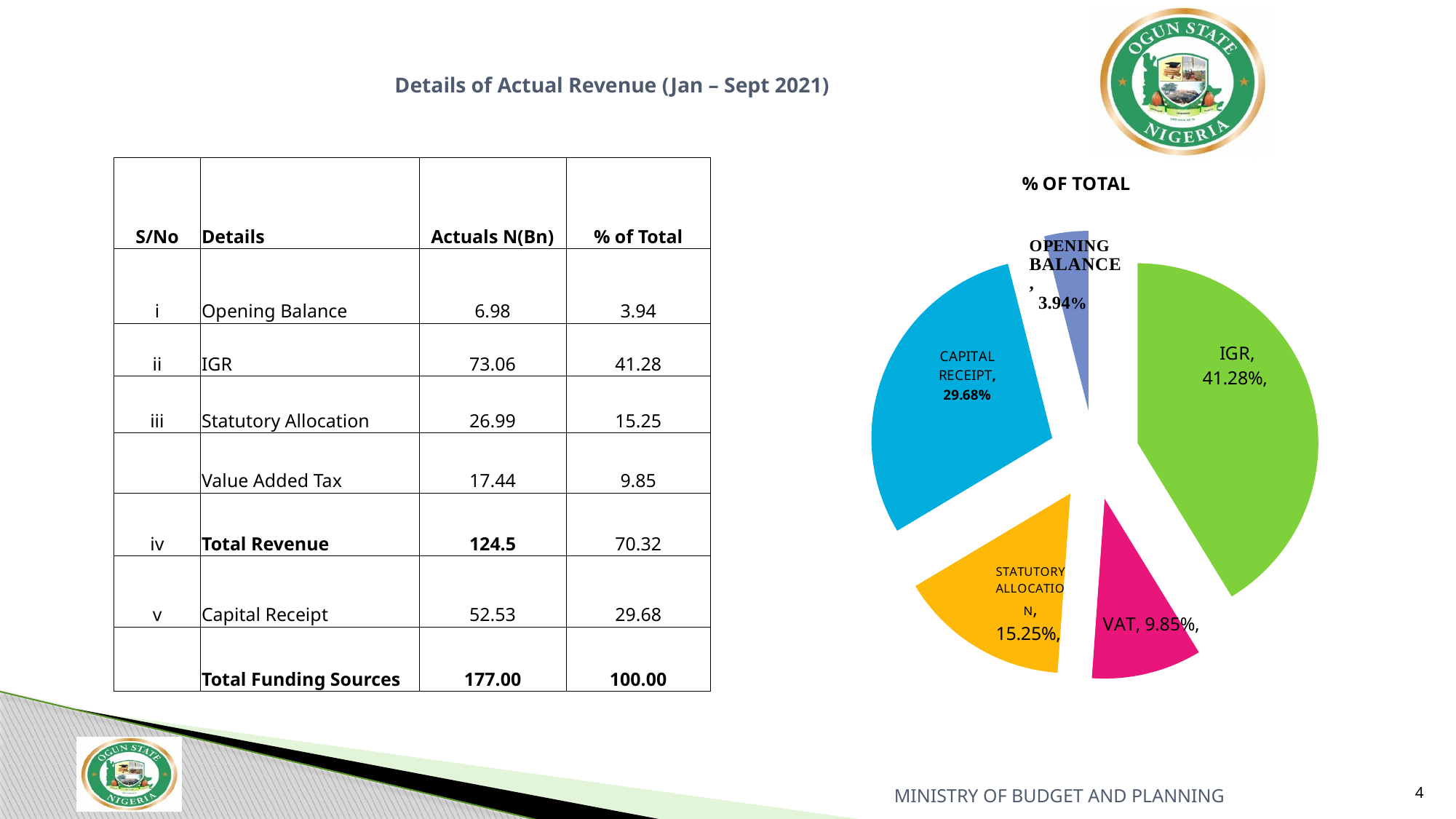
What share of the pie does Capital Receipt represent? 29.68% What share of the pie does IGR represent? 41.28% What type of chart is shown on the slide? pie chart What share of the pie does Opening Balance represent? 3.94% What is the difference in percentage points between the IGR slice and the Capital Receipt slice? 11.6 What is the title of the chart? % OF TOTAL Which slice of the pie chart is the largest? IGR Which slice is larger, Statutory Allocation or VAT? Statutory Allocation Which slice of the pie chart is the smallest? Opening Balance How many slices does the pie chart have? 5